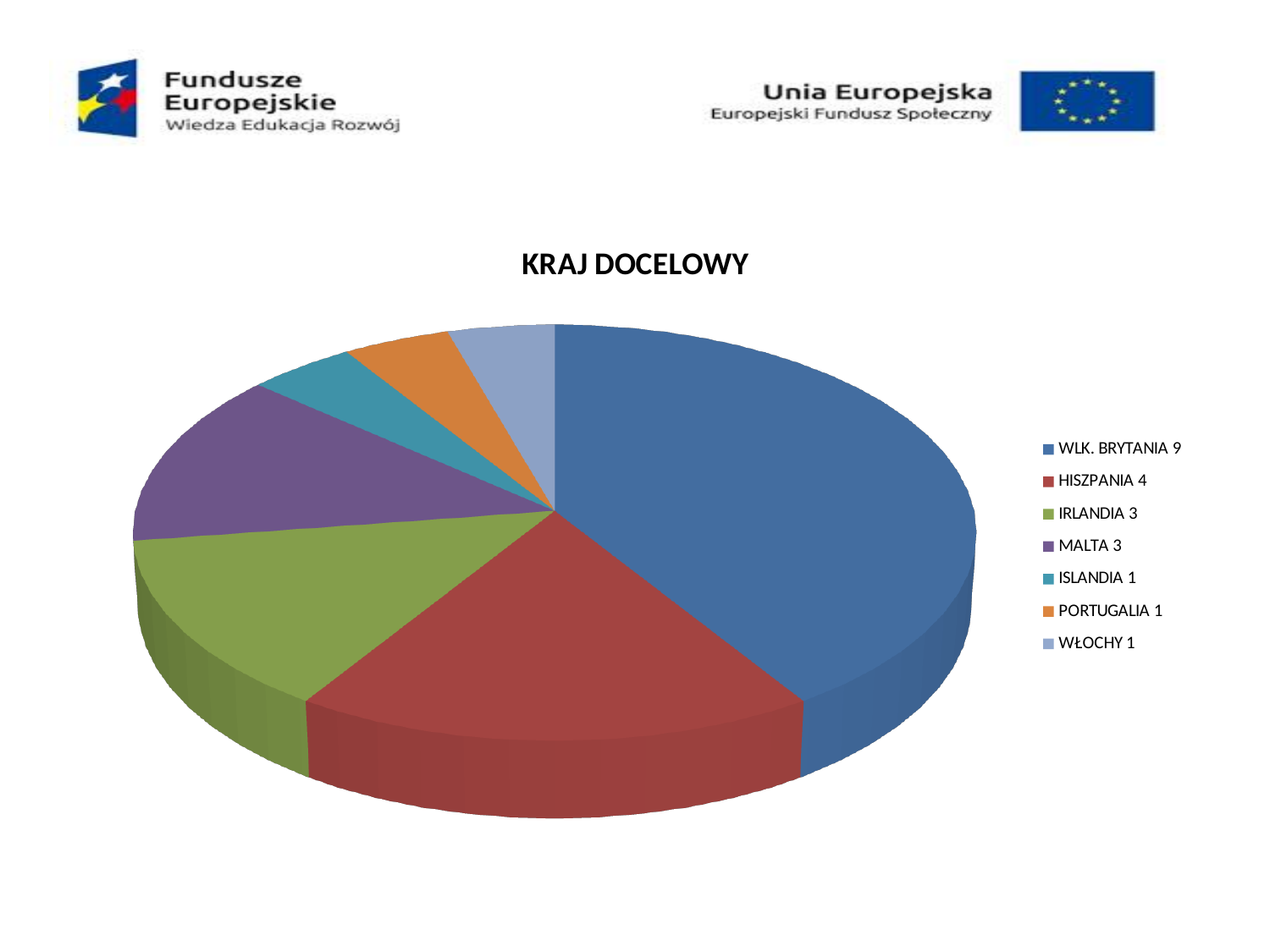
What colour is the slice for WLK. BRYTANIA? blue What is the value for MALTA? 3 Which is larger, the value for HISZPANIA or the value for IRLANDIA? HISZPANIA What is the title of the chart? KRAJ DOCELOWY What type of chart is shown on the slide? pie chart What is the difference between the values for WLK. BRYTANIA and HISZPANIA? 5 What is the total of all the values shown in the legend? 22 What is the value for WLK. BRYTANIA? 9 How many categories does the pie chart have? 7 What is the value for PORTUGALIA? 1 What is the value for HISZPANIA? 4 Which category has the largest slice of the pie? WLK. BRYTANIA